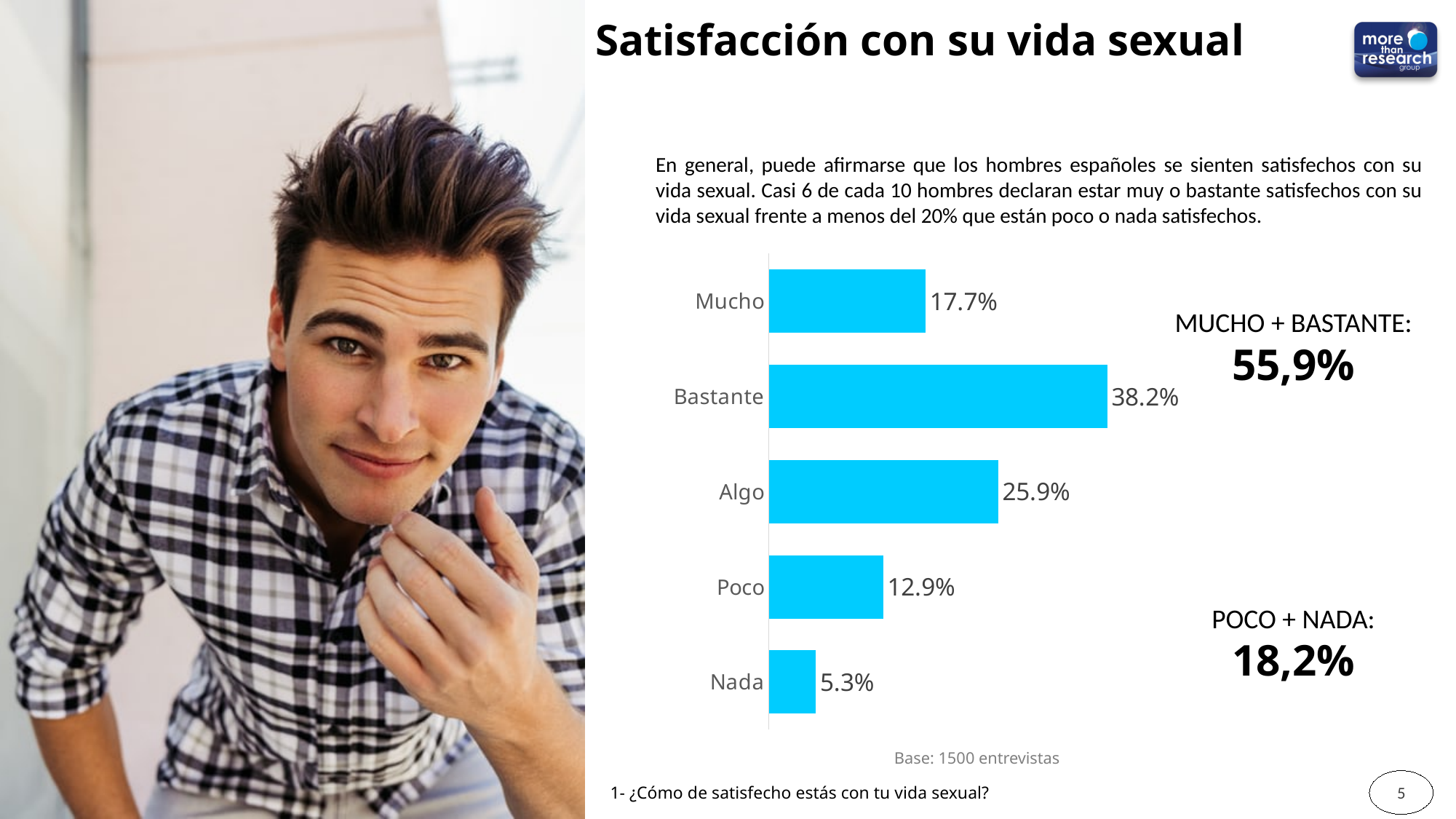
Which is larger, the value for Mucho or the value for Poco? Mucho Which category has the highest value? Bastante What is the value for Nada? 5.3% What is the value for Mucho? 17.7% What is the value for Poco? 12.9% Which category has the lowest value? Nada How many categories are shown in the chart? 5 What is the difference between the values for Bastante and Algo? 12.3% What is the base (number of interviews) stated below the chart? 1500 entrevistas What is the value for Algo? 25.9% What is the value for Bastante? 38.2% What kind of chart is shown on the slide? Bar chart